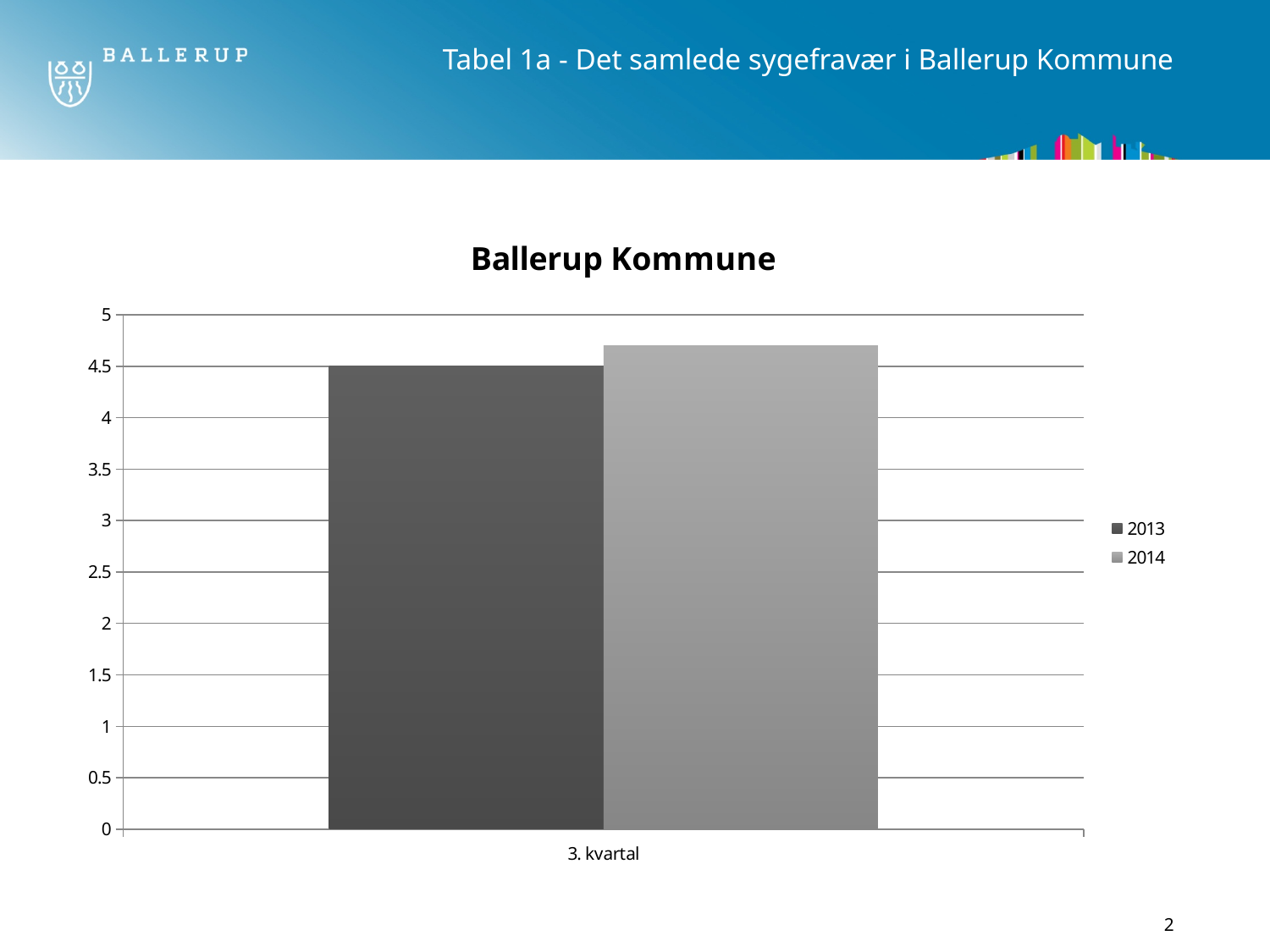
How many series does the legend list? 2 Which series has the larger value in 3. kvartal, 2013 or 2014? 2014 How many categories are shown on the x axis? 1 Which series has the highest bar? 2014 Is the value for 2014 in 3. kvartal greater or less than 4.5? greater Is the value for 2014 in 3. kvartal greater or less than 5? less What is the category label shown on the x axis? 3. kvartal What kind of chart is shown on the slide? bar chart Which series has the lowest bar? 2013 What is the value for 2013 in 3. kvartal? 4.5 What is the title of the chart? Ballerup Kommune